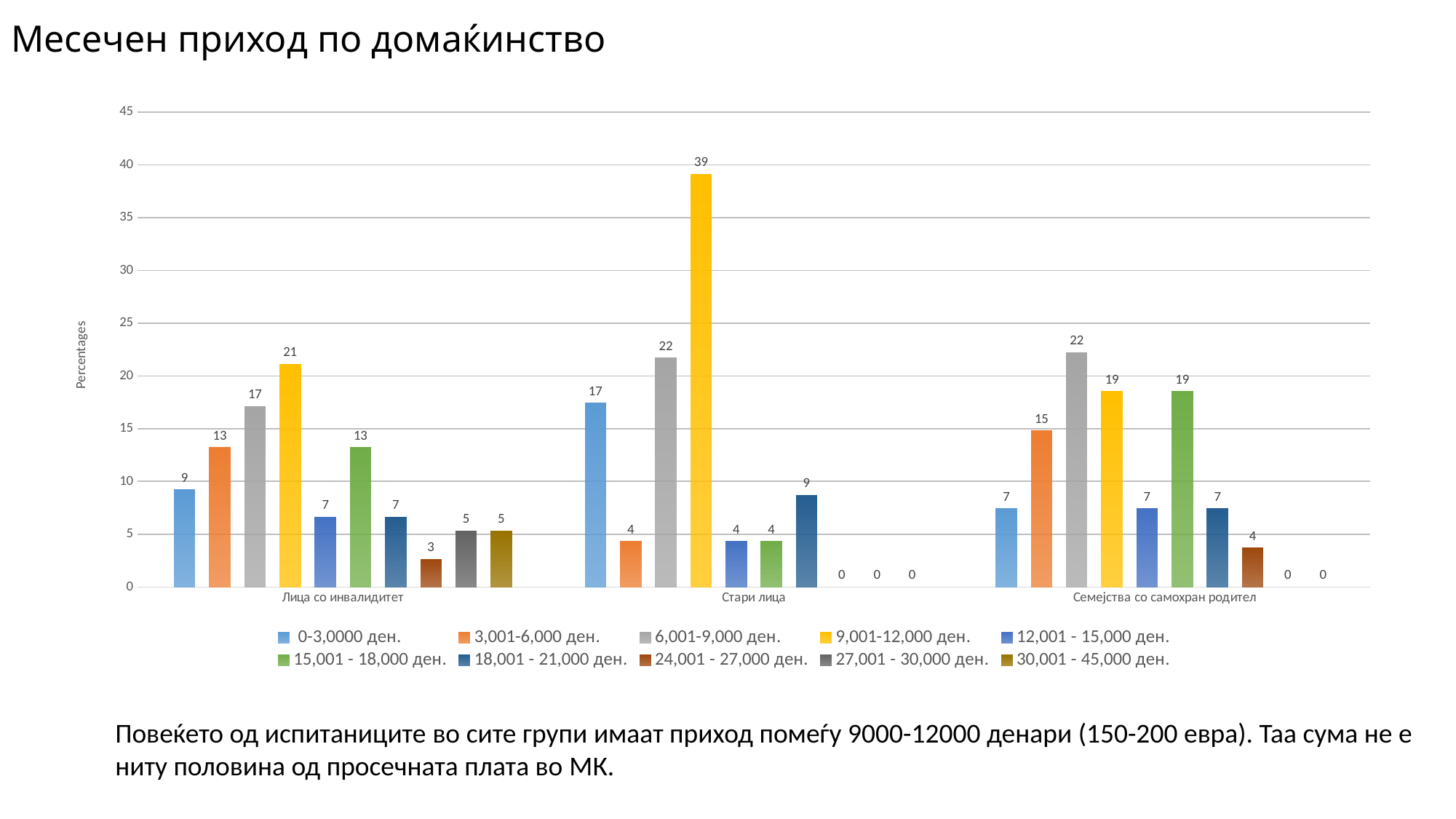
What is the value for 24,001 - 27,000 ден. in the Лица со инвалидитет category? 3 What is the title of the chart? Месечен приход по домаќинство Which income range has the highest value in the Стари лица category? 9,001-12,000 ден. What is the difference between the 9,001-12,000 ден. value for Стари лица and the 9,001-12,000 ден. value for Лица со инвалидитет? 18 What is the value for 0-3,0000 ден. in the Стари лица category? 17 What is the value for 6,001-9,000 ден. in the Семејства со самохран родител category? 22 What is the value for 9,001-12,000 ден. in the Стари лица category? 39 How many series does the legend list? 10 Which is larger in the Семејства со самохран родител category: 3,001-6,000 ден. or 0-3,0000 ден.? 3,001-6,000 ден. How many categories are shown on the x axis? 3 Which income range has the highest value in the Лица со инвалидитет category? 9,001-12,000 ден. What type of chart is shown on the slide? bar chart